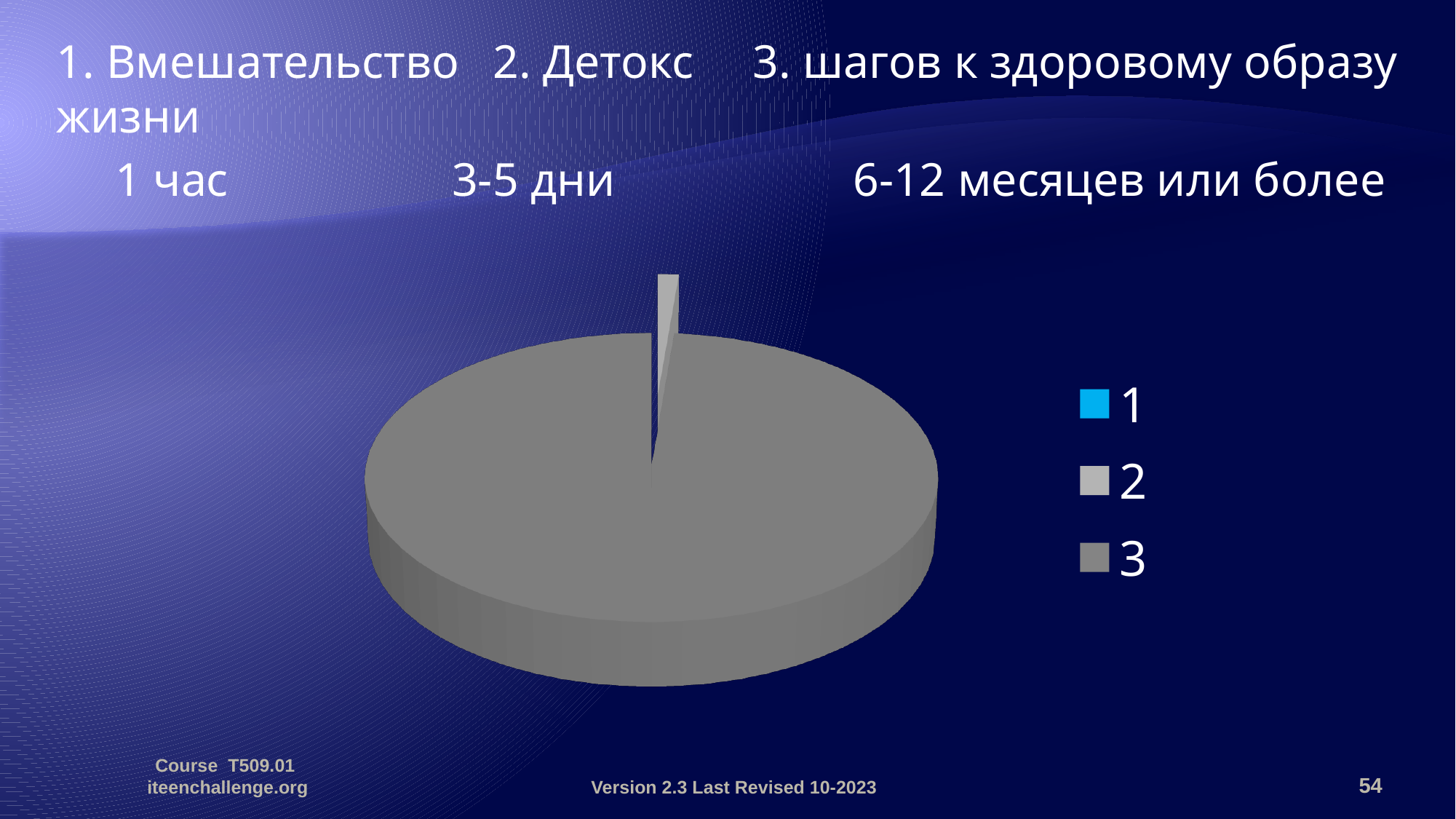
Does the slice for category 3 take up more or less than half of the pie? more Which category has the largest slice of the pie? 3 What kind of chart is shown on the slide? pie chart Which slice is larger, category 2 or category 3? 3 How many entries does the chart legend list? 3 What colour is the slice for category 3 in the pie chart? dark gray Which legend entry is shown in blue? 1